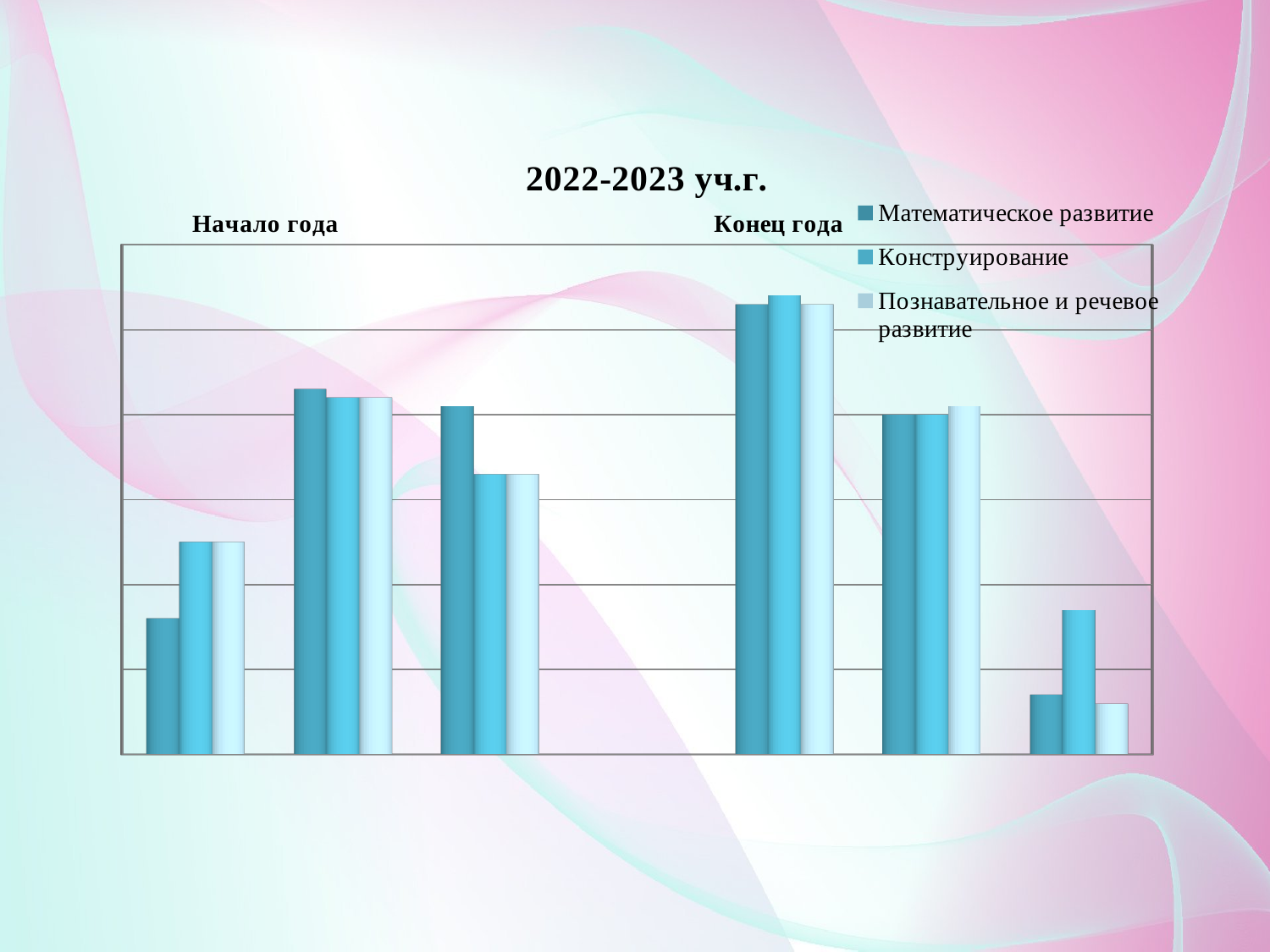
How many series does the legend list? 3 Which series is listed first in the legend? Математическое развитие Which group, Начало года or Конец года, contains the shortest bar on the chart? Конец года What kind of chart is shown on the slide? Bar chart How many labelled groups (periods) are shown on the x axis? 2 What is the title of the chart? 2022-2023 уч.г. Which group, Начало года or Конец года, contains the tallest bar on the chart? Конец года